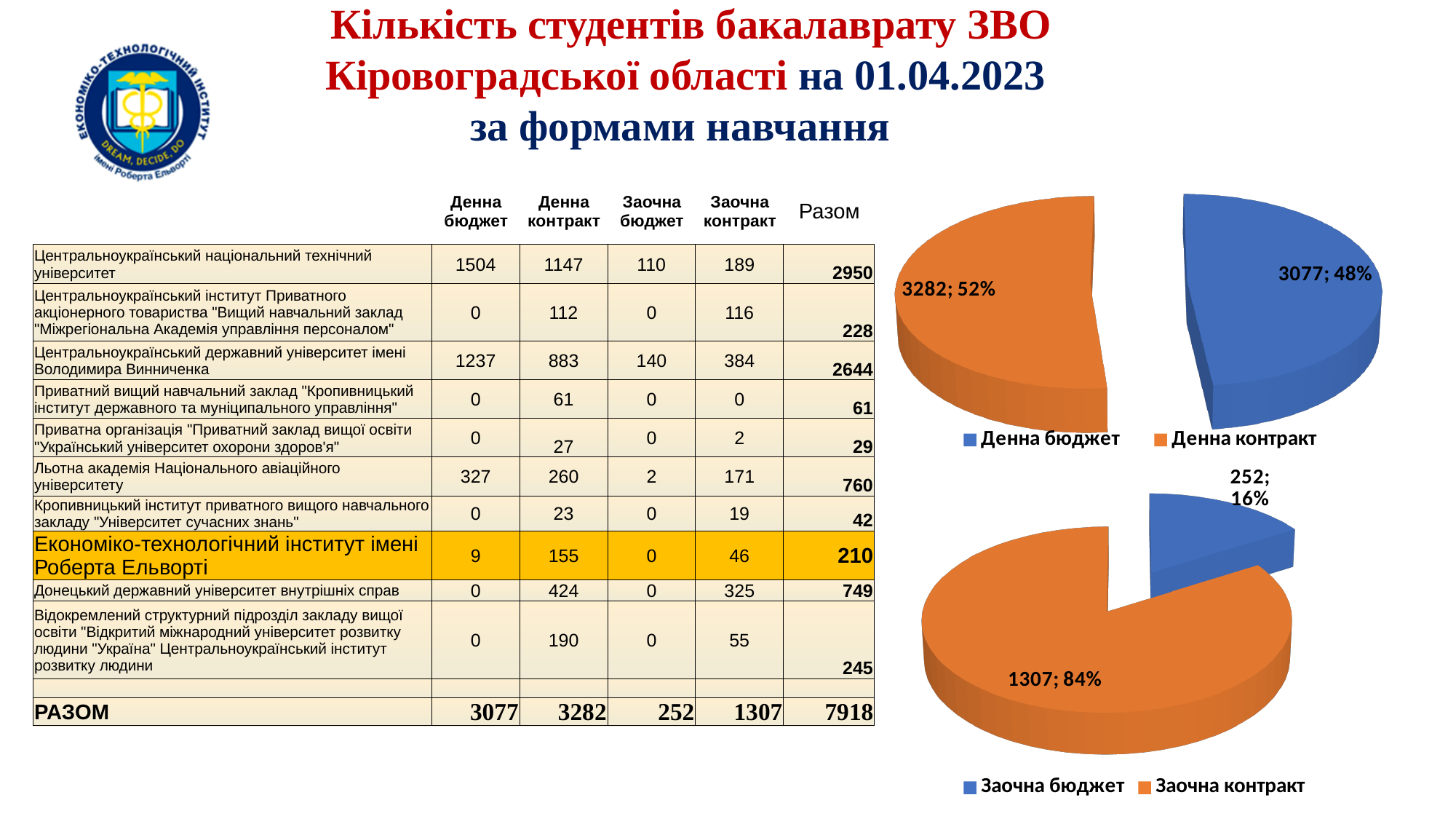
In the top pie chart on the right, what is the difference between the Денна контракт and Денна бюджет values? 205 In the top pie chart on the right, what share of the pie does Денна бюджет take? 48% What kind of chart is the top chart on the right side of the slide? Pie chart In the top pie chart on the right, what value is shown for Денна контракт? 3282 In the bottom pie chart on the right, what is the total of the two slices? 1559 In the bottom pie chart on the right, which slice is the smallest? Заочна бюджет In the bottom pie chart on the right, what share of the pie does Заочна бюджет take? 16% In the bottom pie chart on the right, what colour is the Заочна контракт slice? Orange How many entries does the legend of the bottom pie chart on the right list? 2 In the bottom pie chart on the right, what value is shown for Заочна контракт? 1307 In the top pie chart on the right, what value is shown for Денна бюджет? 3077 In the top pie chart on the right, which slice is larger, Денна бюджет or Денна контракт? Денна контракт